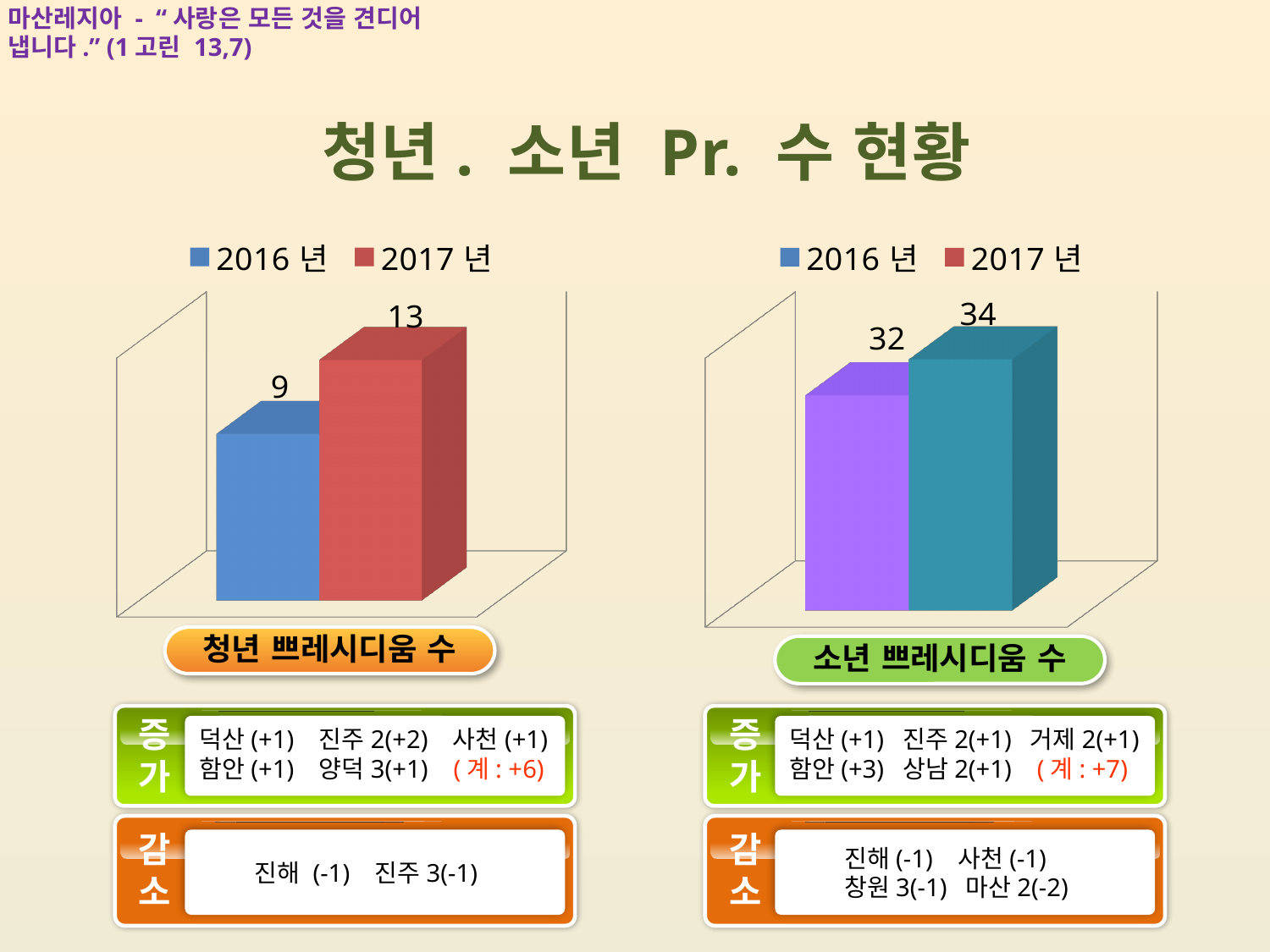
In the right chart (소년 쁘레시디움 수), what is the value for 2016 년? 32 In the left chart (청년 쁘레시디움 수), what is the difference between the 2017 년 and 2016 년 values? 4 In the right chart (소년 쁘레시디움 수), what is the difference between the 2017 년 and 2016 년 values? 2 In the left chart (청년 쁘레시디움 수), which year has the higher value? 2017 년 What kind of chart is the right chart (소년 쁘레시디움 수)? bar chart What are the two legend entries shown above the right chart (소년 쁘레시디움 수)? 2016 년 and 2017 년 Is the 2016 년 value in the right chart (소년 쁘레시디움 수) larger or smaller than the 2017 년 value in the left chart (청년 쁘레시디움 수)? larger In the left chart (청년 쁘레시디움 수), what is the value for 2016 년? 9 In the left chart (청년 쁘레시디움 수), what is the value for 2017 년? 13 How many series does the legend of the left chart (청년 쁘레시디움 수) list? 2 In the right chart (소년 쁘레시디움 수), which year has the lower value? 2016 년 In the right chart (소년 쁘레시디움 수), what is the value for 2017 년? 34